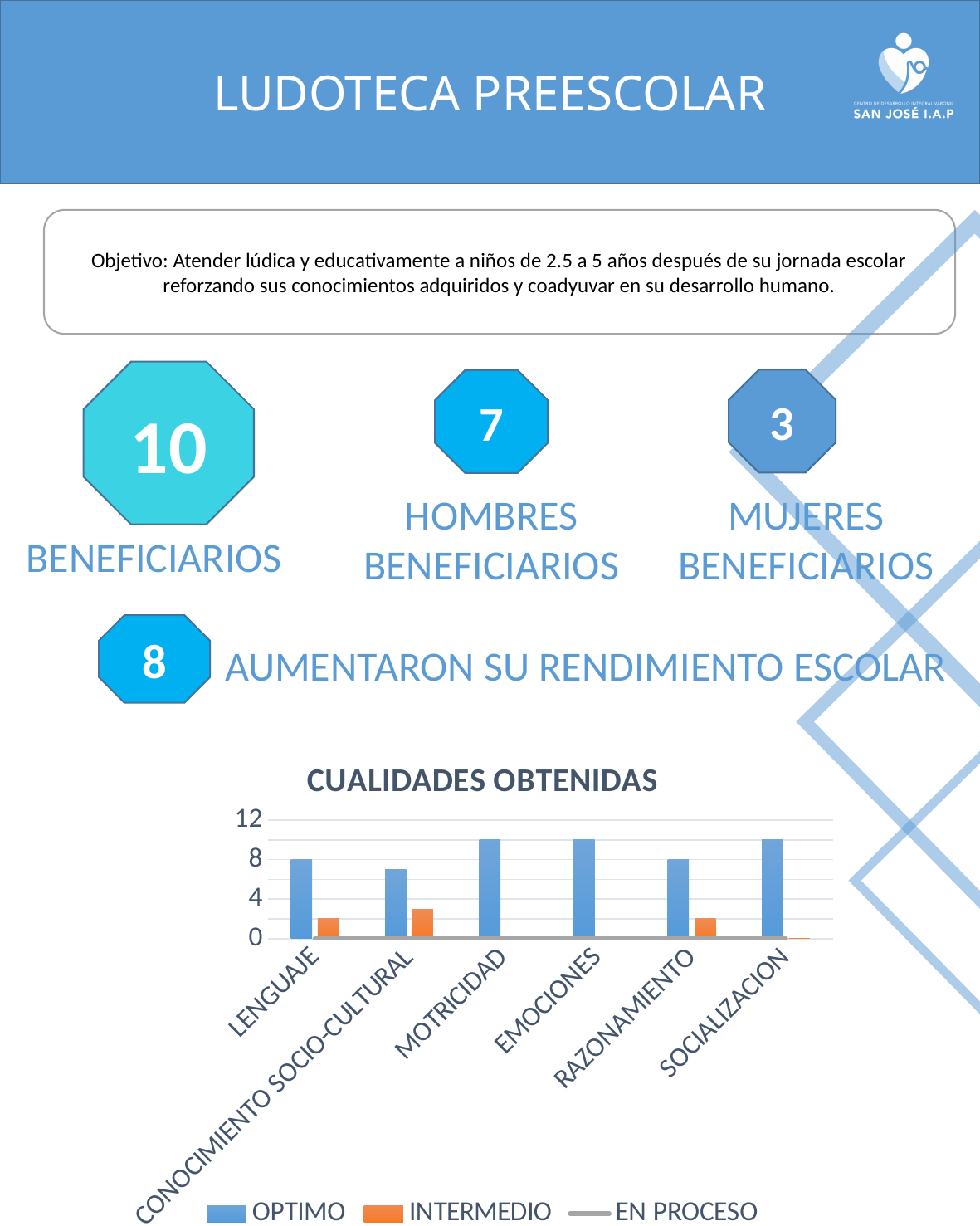
Which has a higher OPTIMO value, MOTRICIDAD or LENGUAJE? MOTRICIDAD How many series does the legend of the CUALIDADES OBTENIDAS chart list? 3 What is the OPTIMO value for LENGUAJE? 8 What colour represents the OPTIMO series in the legend? blue Is the OPTIMO value for CONOCIMIENTO SOCIO-CULTURAL greater or less than 8? less Is the OPTIMO value for MOTRICIDAD greater or less than 8? greater What is the title of the chart on the slide? CUALIDADES OBTENIDAS What kind of chart is shown under the title CUALIDADES OBTENIDAS? bar chart Which has a higher INTERMEDIO value, CONOCIMIENTO SOCIO-CULTURAL or LENGUAJE? CONOCIMIENTO SOCIO-CULTURAL Is the INTERMEDIO value for LENGUAJE greater or less than 4? less Which category has the lowest OPTIMO value? CONOCIMIENTO SOCIO-CULTURAL How many categories are shown on the x axis of the CUALIDADES OBTENIDAS chart? 6